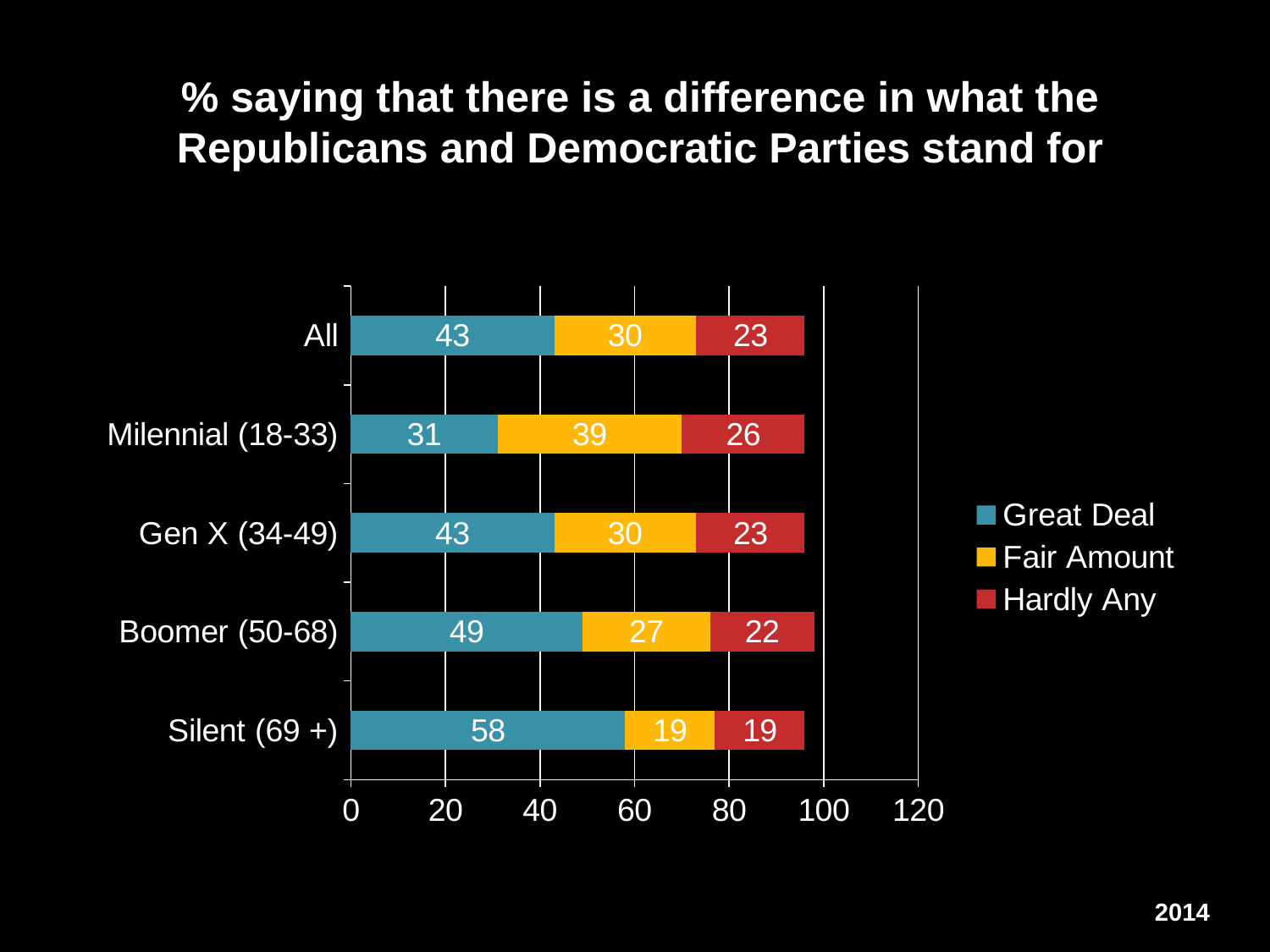
Which category has the lowest Great Deal value? Milennial (18-33) How many categories are shown on the y axis? 5 Which category has the highest Great Deal value? Silent (69 +) Which is larger, the Fair Amount value for Milennial (18-33) or for Boomer (50-68)? Milennial (18-33) Which colour represents the Hardly Any series? Red How many series does the legend list? 3 What is the total of the stacked bar for Boomer (50-68)? 98 What is the difference between the Great Deal values for Silent (69 +) and Milennial (18-33)? 27 What is the Fair Amount value for Milennial (18-33)? 39 What kind of chart is shown? Stacked bar chart What is the Great Deal value for Silent (69 +)? 58 What is the Hardly Any value for Boomer (50-68)? 22